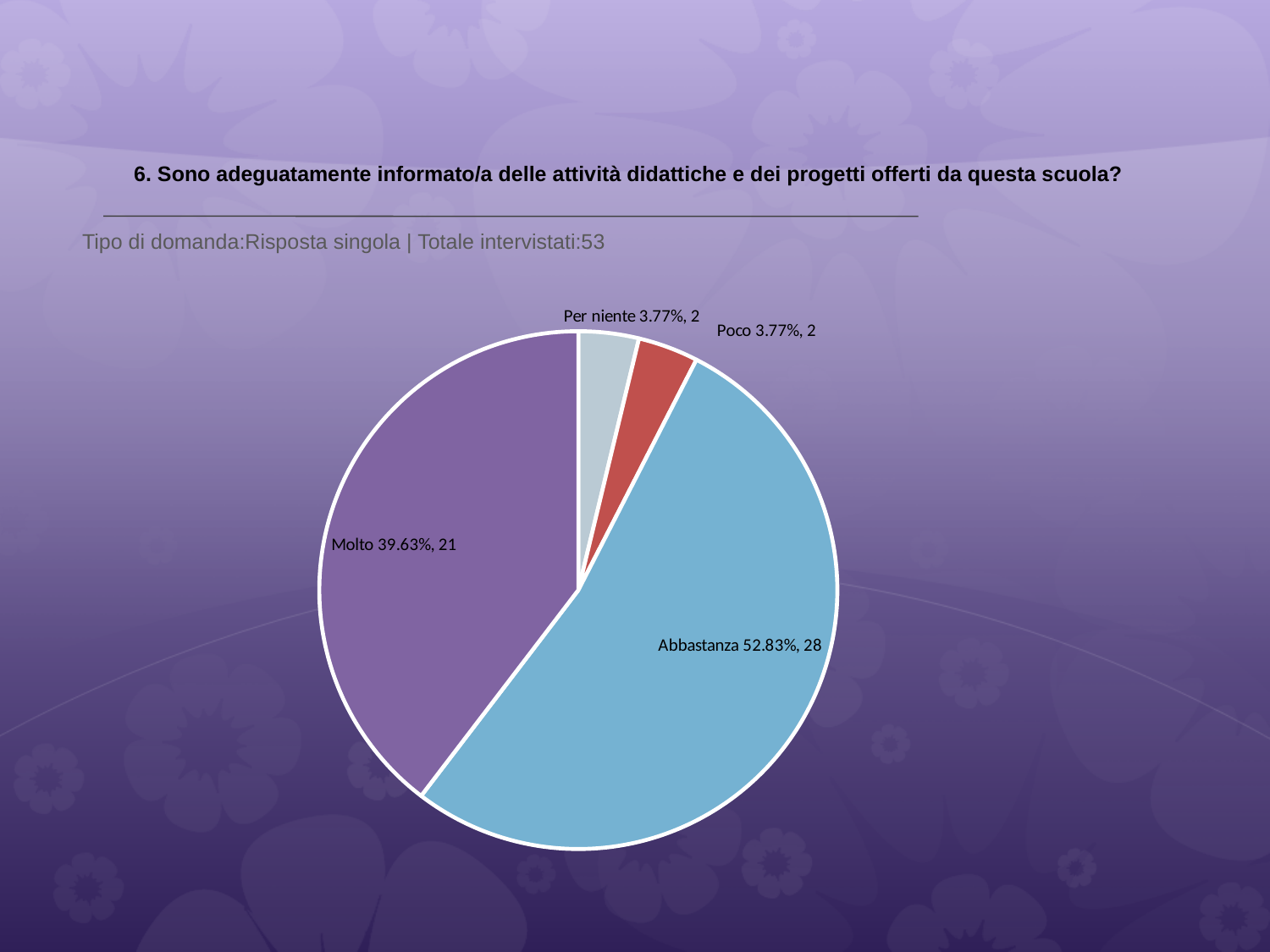
How many slices does the pie chart have? 4 What is the difference in respondent count between Abbastanza and Molto? 7 Which category has the largest slice of the pie? Abbastanza What colour is the Abbastanza slice? blue Which has more respondents, Molto or Abbastanza? Abbastanza What percentage share does the Abbastanza slice have? 52.83% How many respondents answered Molto? 21 How many respondents answered Poco? 2 What percentage share does the Molto slice have? 39.63% How many respondents answered Abbastanza? 28 What is the total number of respondents across all slices? 53 What kind of chart is shown on the slide? pie chart